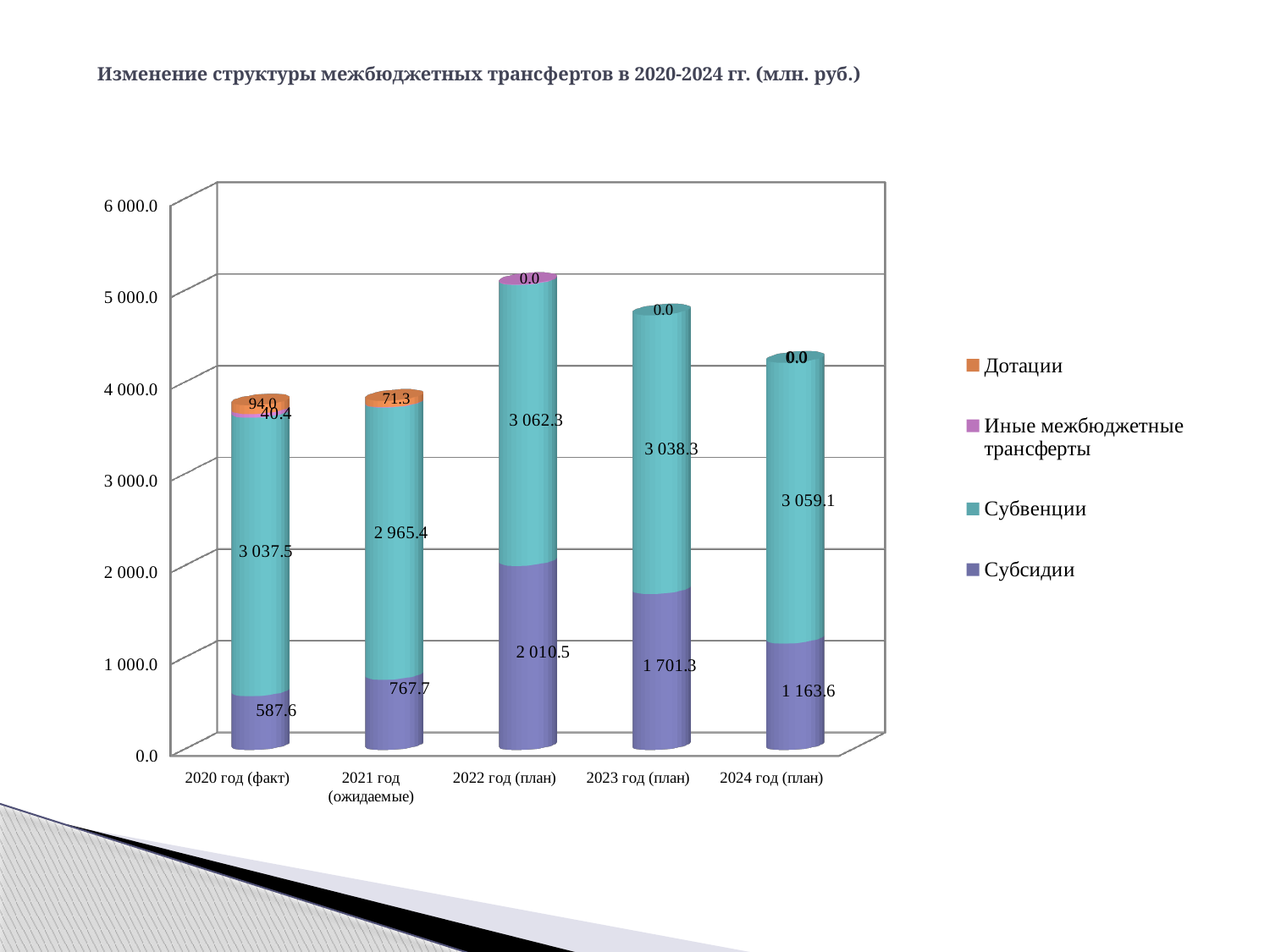
What is the value of Субсидии for 2024 год (план)? 1 163.6 Is the total height of the bar for 2024 год (план) greater or less than 5 000.0? less What type of chart is shown on the slide? Stacked bar chart What is the value of Субвенции for 2021 год (ожидаемые)? 2 965.4 How many year categories are shown on the x axis? 5 In which year is the Субсидии value the highest? 2022 год (план) In which year is the Субсидии value the lowest? 2020 год (факт) How many series does the legend list? 4 What is the value of Дотации for 2020 год (факт)? 94.0 Which is larger: Субсидии for 2023 год (план) or Субсидии for 2024 год (план)? 2023 год (план) What is the difference between the Субсидии values for 2022 год (план) and 2020 год (факт)? 1 422.9 What is the value of Субсидии for 2020 год (факт)? 587.6